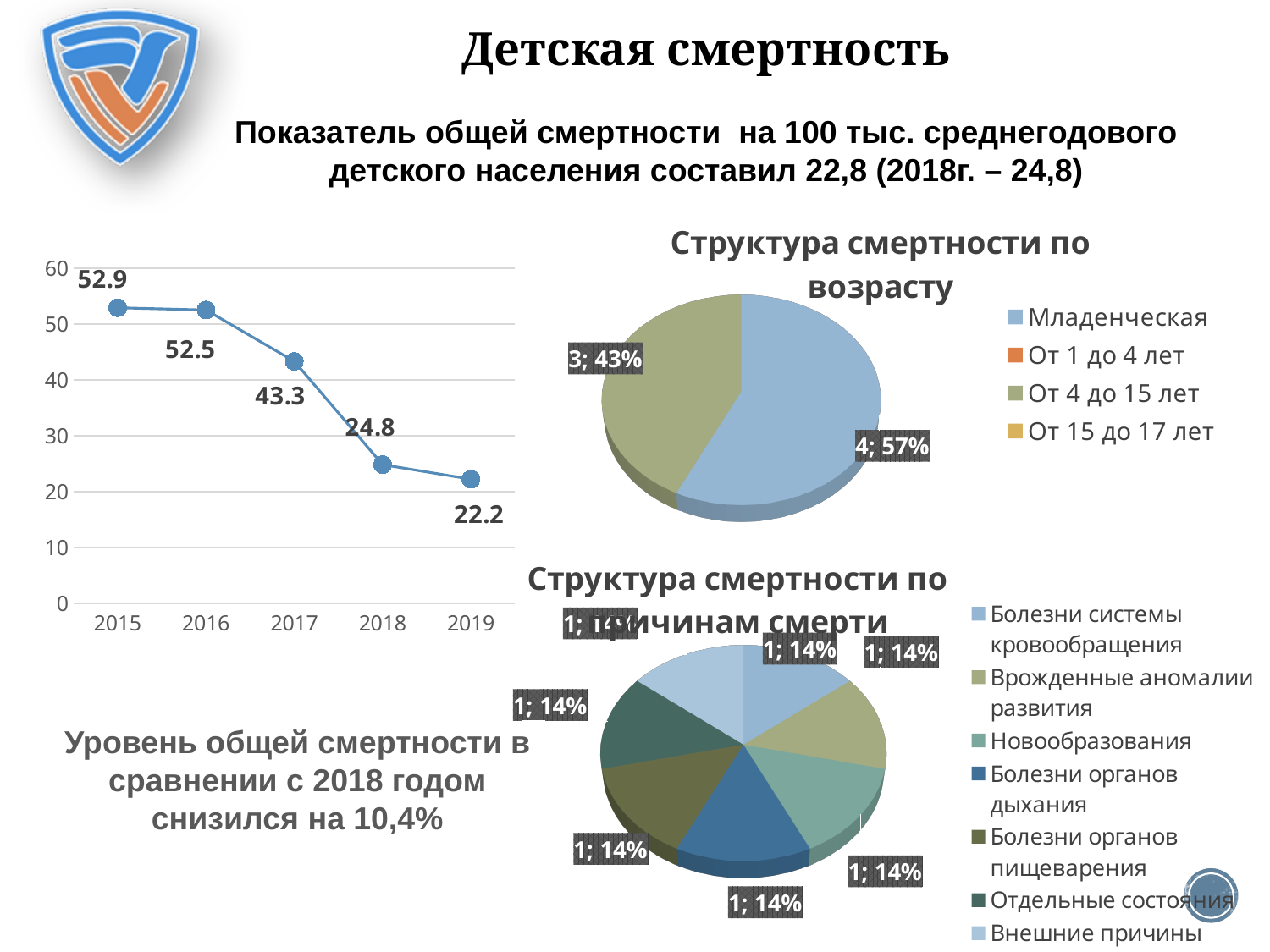
On the line chart on the left of the slide, what is the value for 2019? 22.2 On the line chart on the left of the slide, do the values rise or fall from 2015 to 2019? fall On the line chart on the left of the slide, what kind of chart is it? line chart On the line chart on the left of the slide, which year has the highest value? 2015 On the line chart on the left of the slide, what is the value for 2017? 43.3 On the line chart on the left of the slide, what is the difference between the values for 2018 and 2019? 2.6 In the pie chart 'Структура смертности по возрасту', what is the value shown for 'От 4 до 15 лет'? 3 In the pie chart 'Структура смертности по возрасту', what share does the 'Младенческая' slice have? 57% On the line chart on the left of the slide, how many years are plotted? 5 On the line chart on the left of the slide, which year has the lowest value? 2019 How many entries does the legend of the pie chart 'Структура смертности по причинам смерти' list? 7 On the line chart on the left of the slide, what is the value for 2015? 52.9